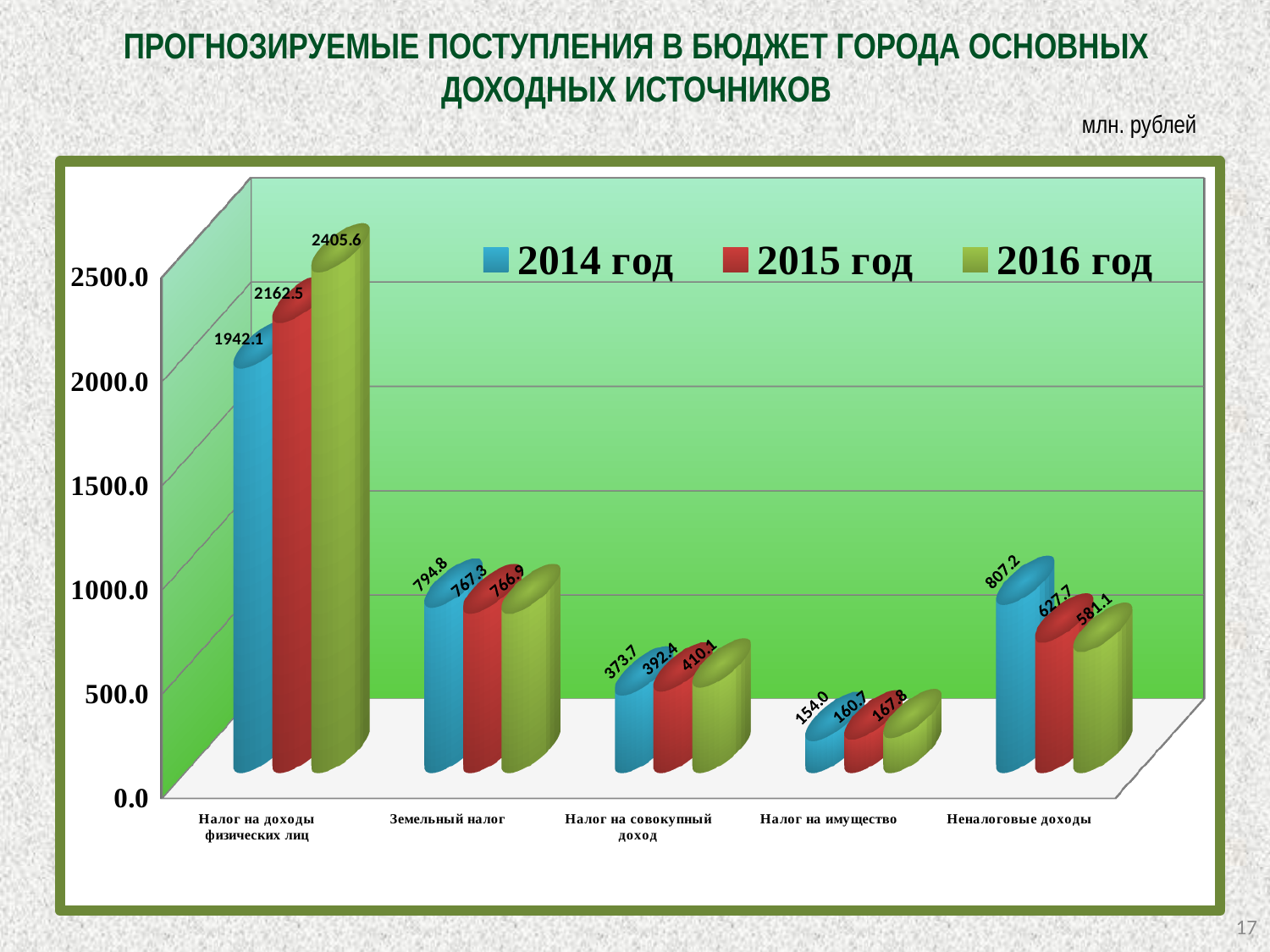
Do the values for Налог на совокупный доход rise or fall from 2014 год to 2016 год? rise What is the value for Налог на имущество in 2015 год? 160.7 Which category has the highest value in 2015 год? Налог на доходы физических лиц Which is larger for Неналоговые доходы: the 2014 год value or the 2016 год value? 2014 год What is the value for Неналоговые доходы in 2014 год? 807.2 What is the difference between the 2016 год and 2014 год values for Налог на доходы физических лиц? 463.5 What kind of chart is shown on the slide? bar chart What is the forecast value for Налог на доходы физических лиц in 2016 год? 2405.6 How many series does the legend list? 3 What is the value for Земельный налог in 2016 год? 766.9 How many categories are shown on the x axis? 5 Which category has the lowest value in 2014 год? Налог на имущество